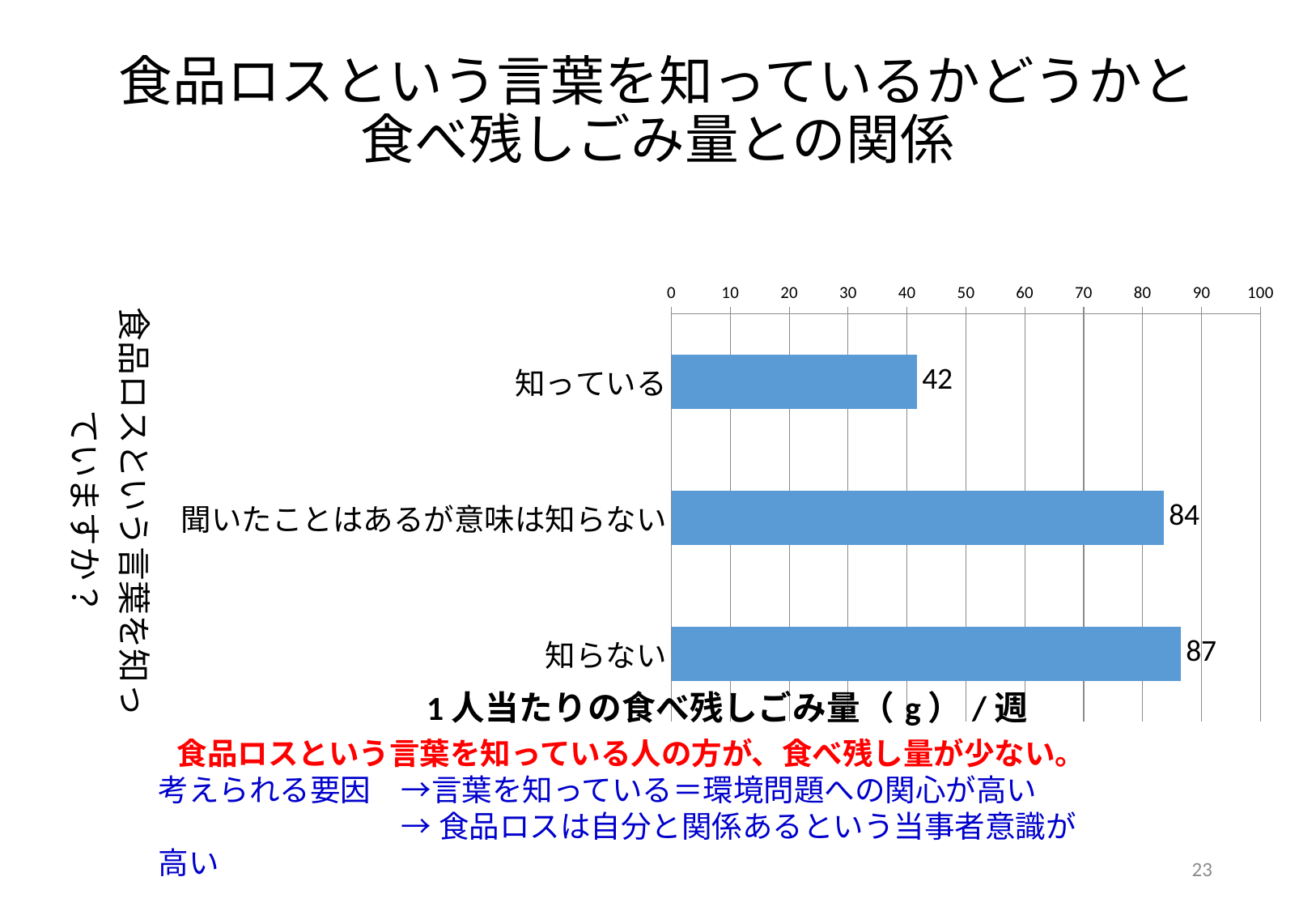
What kind of chart is shown on the slide? bar chart What is the value for 知らない? 87 Which category has the highest value? 知らない What is the value for 知っている? 42 Is the value for 知っている greater or less than 50? less How many categories are shown in the chart? 3 What is the value for 聞いたことはあるが意味は知らない? 84 Which is larger, the value for 知っている or the value for 聞いたことはあるが意味は知らない? 聞いたことはあるが意味は知らない Which category has the lowest value? 知っている What is the difference between the values for 知らない and 知っている? 45 What is the difference between the values for 聞いたことはあるが意味は知らない and 知っている? 42 What is the label on the horizontal axis of the chart? 1人当たりの食べ残しごみ量（g）/週